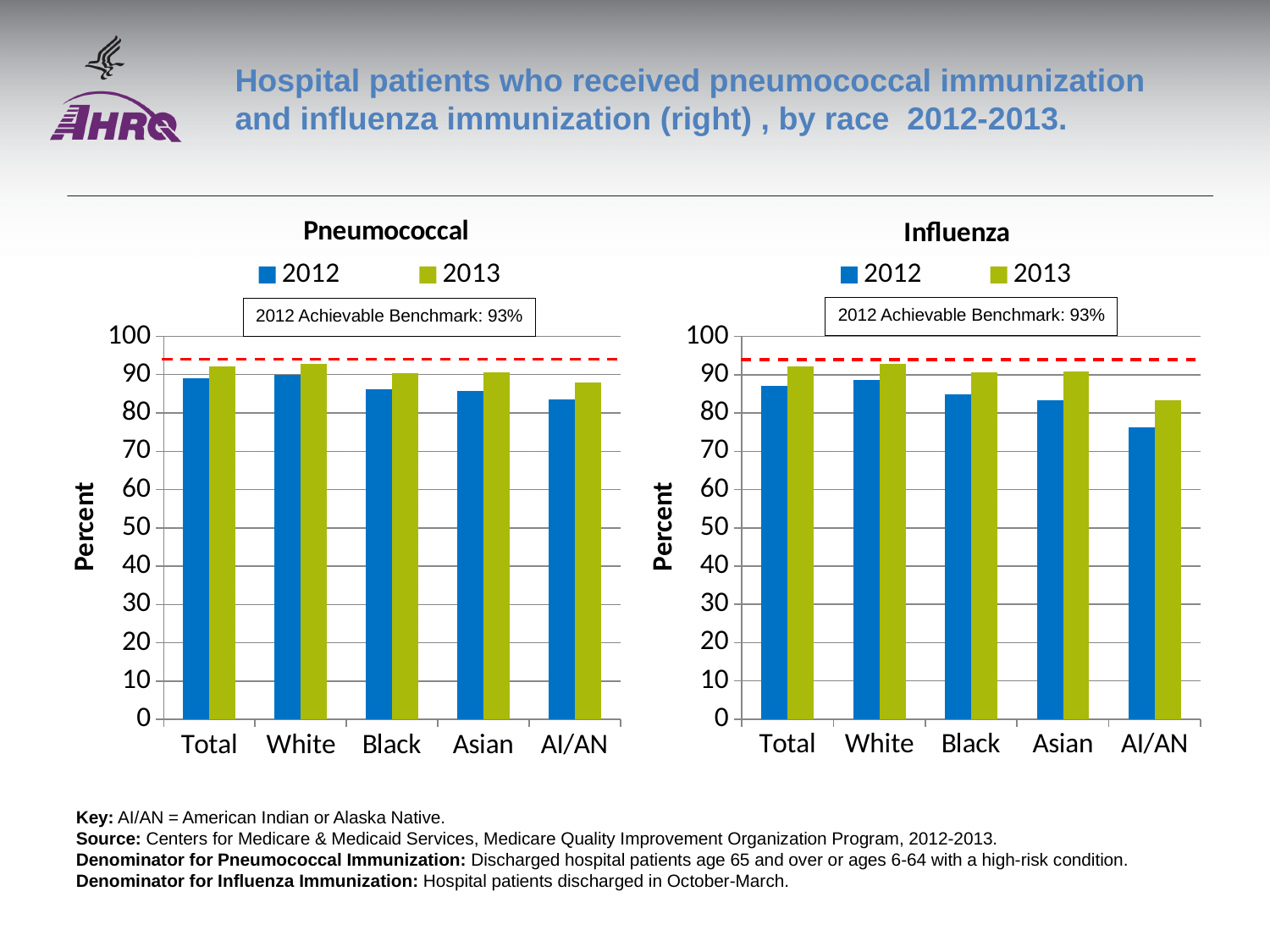
In the Influenza chart, which category has the lowest 2012 value? AI/AN In the Pneumococcal chart, is the 2012 value for AI/AN greater or less than 80? greater In the Influenza chart, which is larger for AI/AN: the 2012 value or the 2013 value? 2013 What kind of chart is the Pneumococcal chart on the left? Bar chart Which two years are listed in the legend of the Pneumococcal chart? 2012 and 2013 In the Influenza chart, is the 2012 value for AI/AN greater or less than 80? less What 2012 Achievable Benchmark is shown on the Influenza chart? 93% How many series does the legend of the Pneumococcal chart list? 2 In the Pneumococcal chart, is the 2012 value for Black greater or less than 90? less In the Pneumococcal chart, which is larger for 2013: White or AI/AN? White How many race categories are shown on the x axis of the Influenza chart? 5